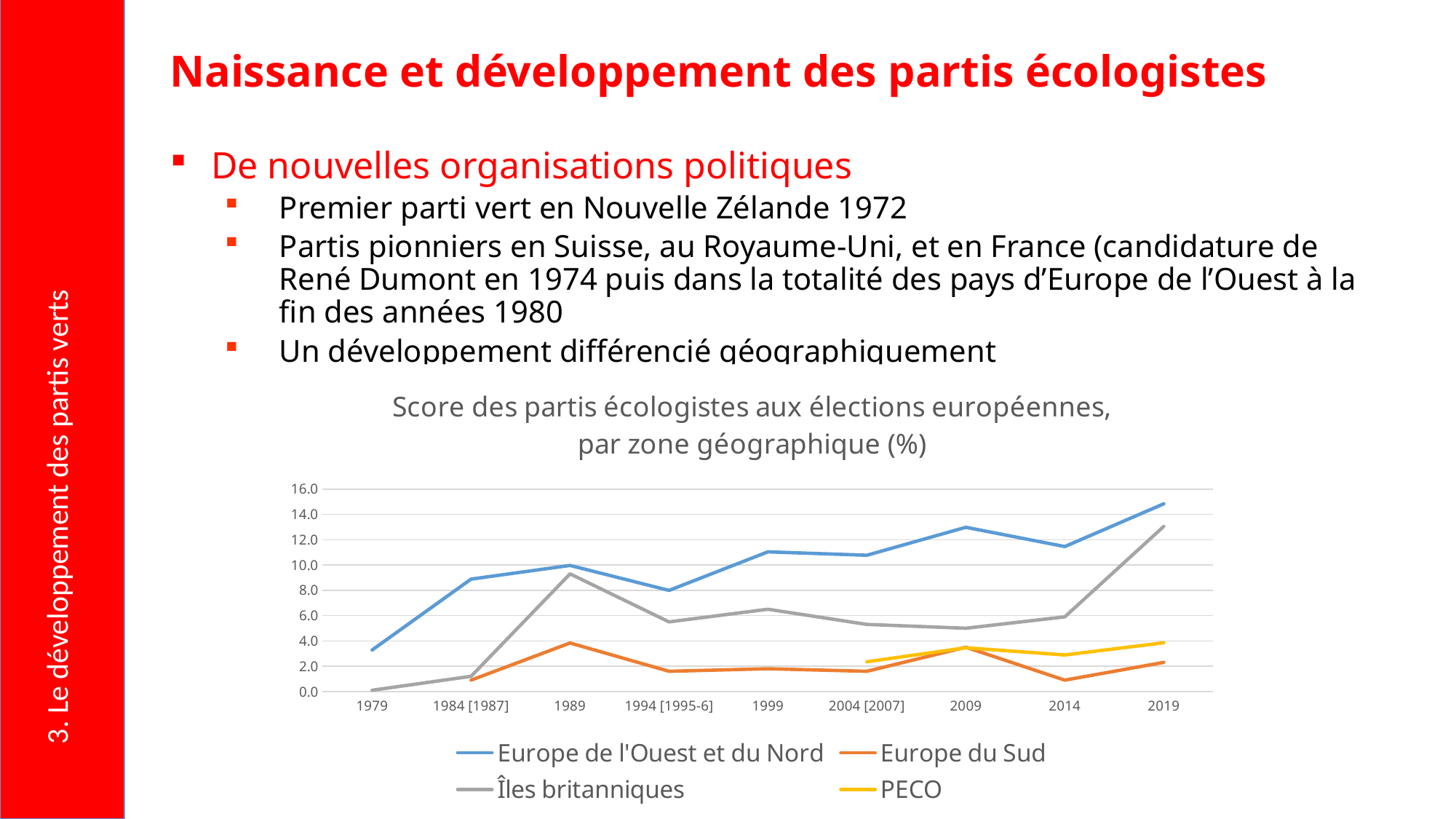
Is the value for Îles britanniques in 1989 greater or less than 8.0? greater Does the value for Îles britanniques rise or fall between 2014 and 2019? rise In 2014, which is larger: Europe de l'Ouest et du Nord or Îles britanniques? Europe de l'Ouest et du Nord Is the value for Europe de l'Ouest et du Nord in 2019 greater or less than 14.0? greater In which year does Îles britanniques have its lowest value? 1979 How many series does the legend of the chart list? 4 Which series only begins at 2004 [2007] on the chart? PECO What kind of chart is shown on the slide? line chart How many election years are shown on the x axis of the chart? 9 In which year does Europe de l'Ouest et du Nord reach its highest value? 2019 Is the value for Europe du Sud in 2014 greater or less than 2.0? less Which series has the highest value in 2019? Europe de l'Ouest et du Nord